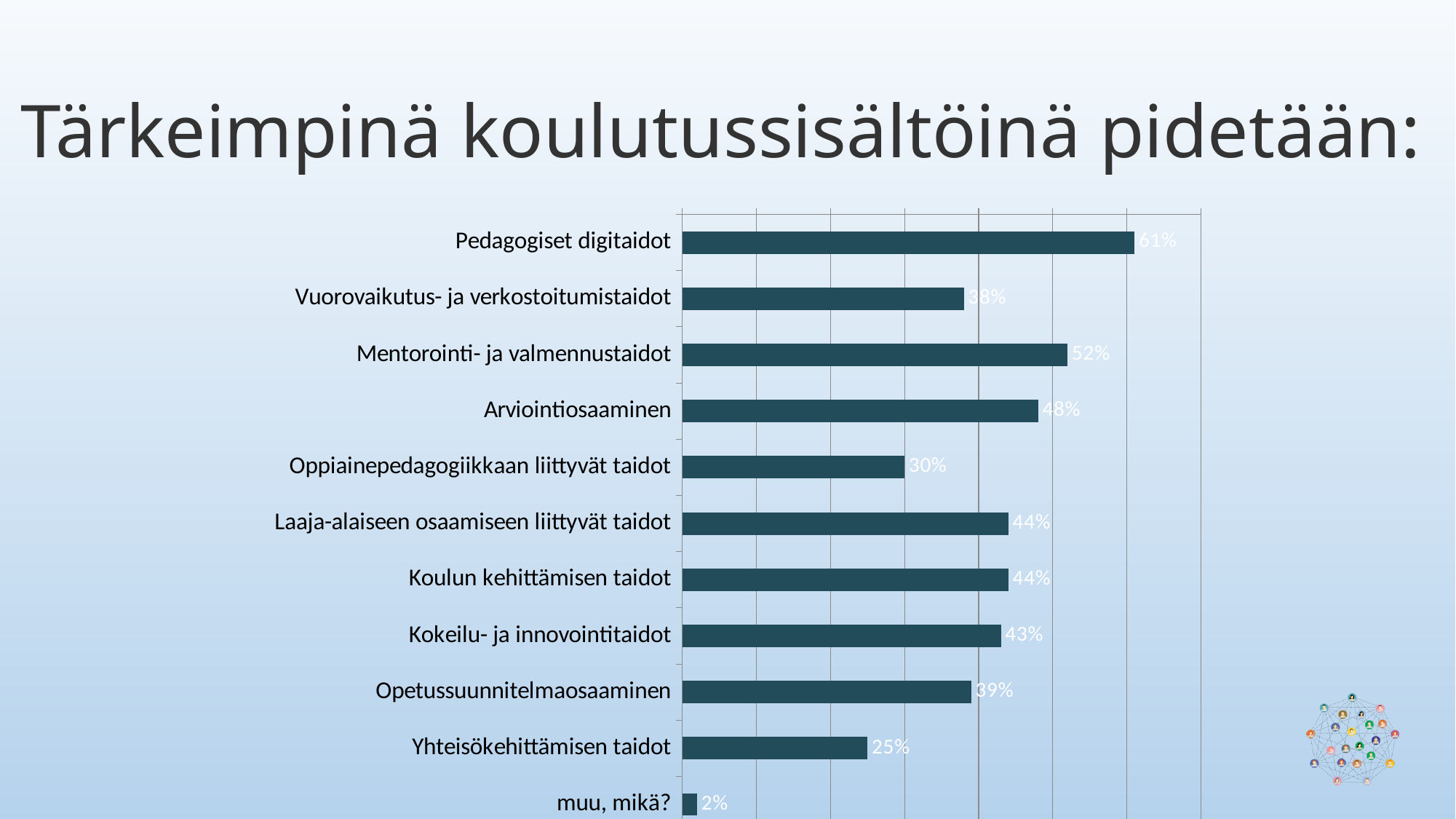
What is the value for Yhteisökehittämisen taidot? 25% What is the value for Opetussuunnitelmaosaaminen? 39% Which category has the lowest value? muu, mikä? What kind of chart is shown on the slide? Bar chart Which category has the highest value? Pedagogiset digitaidot What is the difference between the values for Oppiainepedagogiikkaan liittyvät taidot and Yhteisökehittämisen taidot? 5% How many categories are shown in the chart? 11 What is the value for Pedagogiset digitaidot? 61% What is the value for Arviointiosaaminen? 48% What is the difference between the values for Pedagogiset digitaidot and Mentorointi- ja valmennustaidot? 9% What is the title of the slide? Tärkeimpinä koulutussisältöinä pidetään: Which is larger, the value for Vuorovaikutus- ja verkostoitumistaidot or the value for Kokeilu- ja innovointitaidot? Kokeilu- ja innovointitaidot